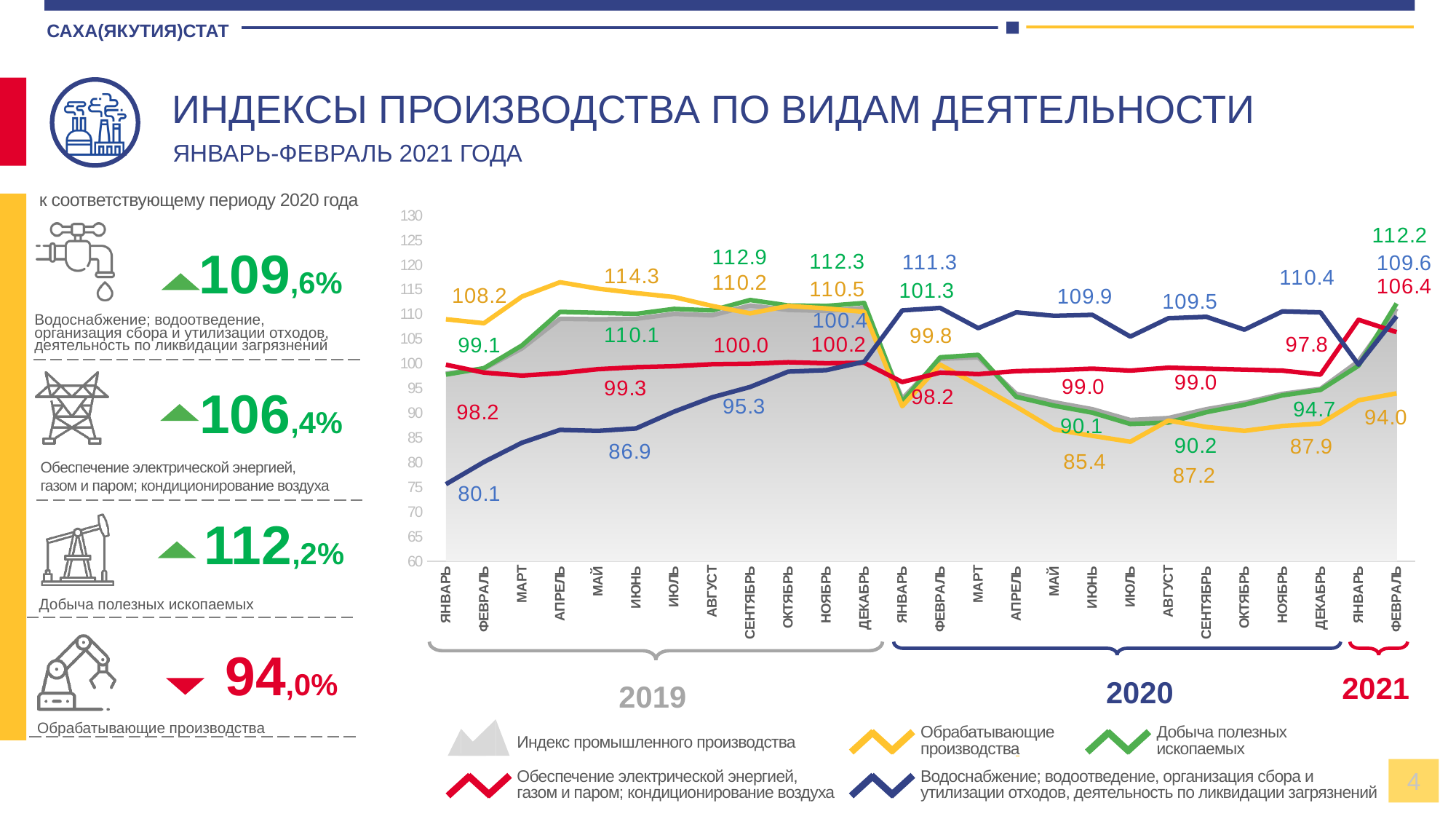
In January 2019, which is larger: Обрабатывающие производства or Водоснабжение; водоотведение? Обрабатывающие производства Which series has the highest value in February 2021? Добыча полезных ископаемых Does the Водоснабжение; водоотведение series rise or fall over the course of 2019? rises Is the value for Обрабатывающие производства in April 2019 greater or less than 110? greater What is the value of Добыча полезных ископаемых in February 2021? 112.2 Which series has the lowest value in February 2021? Обрабатывающие производства What is the difference between Добыча полезных ископаемых and Обрабатывающие производства in February 2021? 18.2 Which series is drawn as a shaded grey area rather than a line? Индекс промышленного производства What kind of chart is shown on the slide? combination area and line chart How many series does the chart legend list? 5